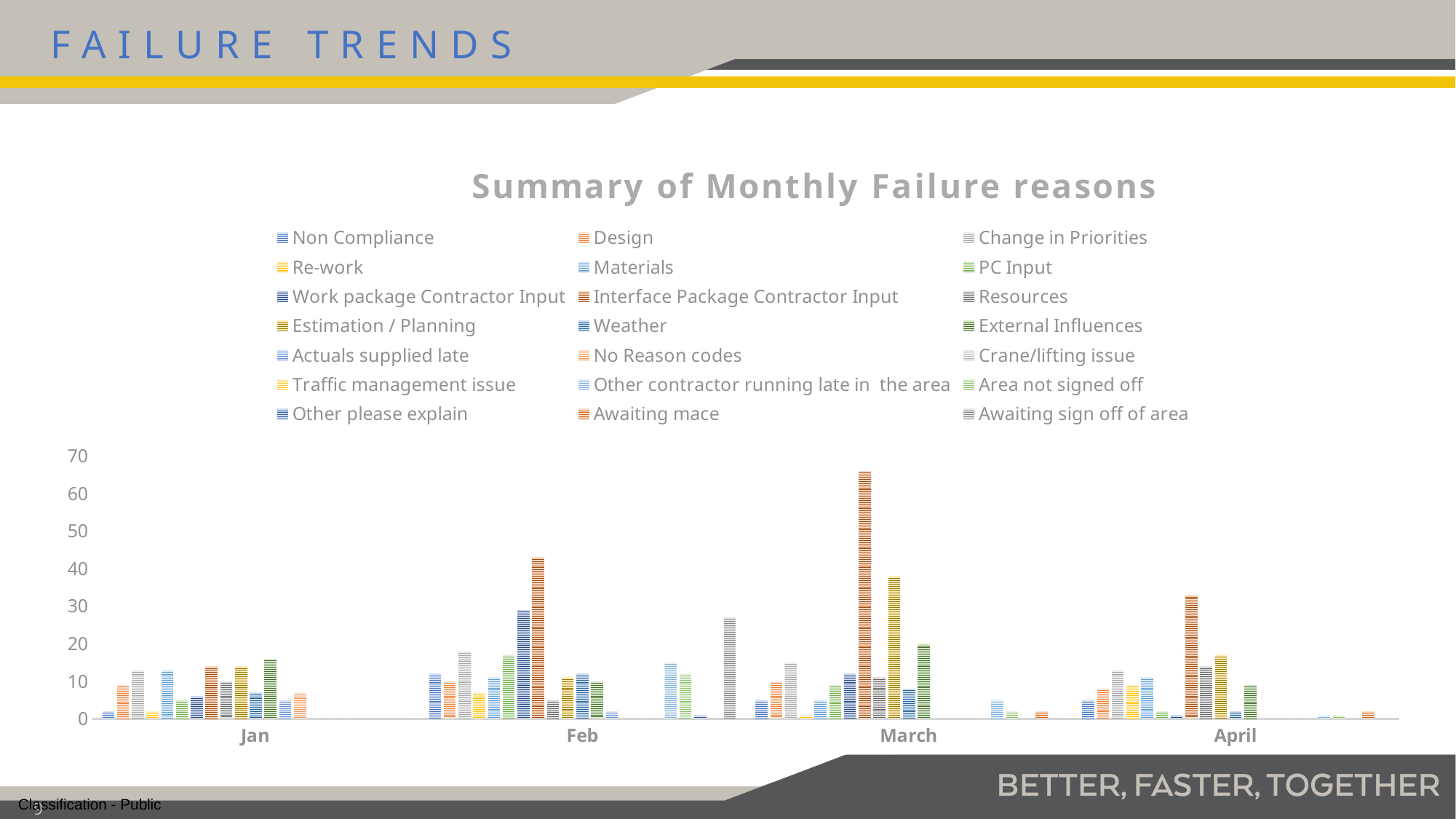
Which month has the lowest maximum bar height? Jan What is the title of the chart? Summary of Monthly Failure reasons Is the tallest bar in April greater or less than 30? greater Is the tallest bar in March greater or less than 60? greater How many series does the chart legend list? 21 Is the tallest bar in Feb greater or less than 40? greater Which month has a taller maximum bar, Feb or April? Feb What type of chart is shown on the slide? Bar chart How many months are shown along the x axis of the chart? 4 What is the highest value shown on the vertical axis? 70 Which month contains the tallest bar in the chart? March